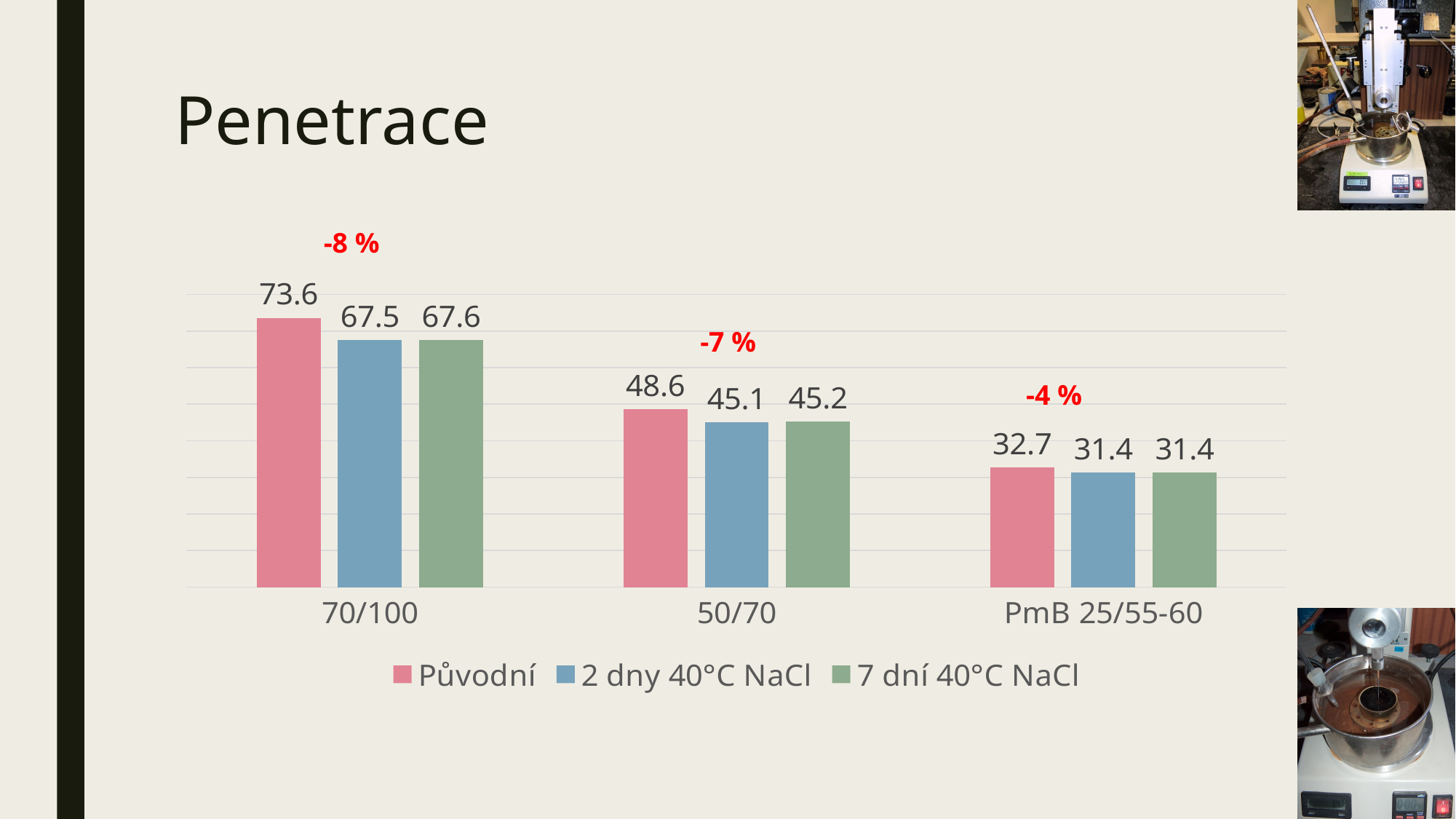
What percentage change is annotated in red above the 50/70 group? -7 % Which category has the lowest 7 dní 40°C NaCl value? PmB 25/55-60 What is the 7 dní 40°C NaCl value for PmB 25/55-60? 31.4 How many categories are shown on the x axis? 3 What is the difference between the Původní value and the 2 dny 40°C NaCl value for 70/100? 6.1 What is the 2 dny 40°C NaCl value for 50/70? 45.1 Which category has the highest Původní value? 70/100 What is the Původní value for 70/100? 73.6 How many series does the legend list? 3 Which is larger: the Původní value for 50/70 or the Původní value for PmB 25/55-60? 50/70 What is the difference between the Původní value and the 7 dní 40°C NaCl value for 50/70? 3.4 What kind of chart is shown on the slide? bar chart